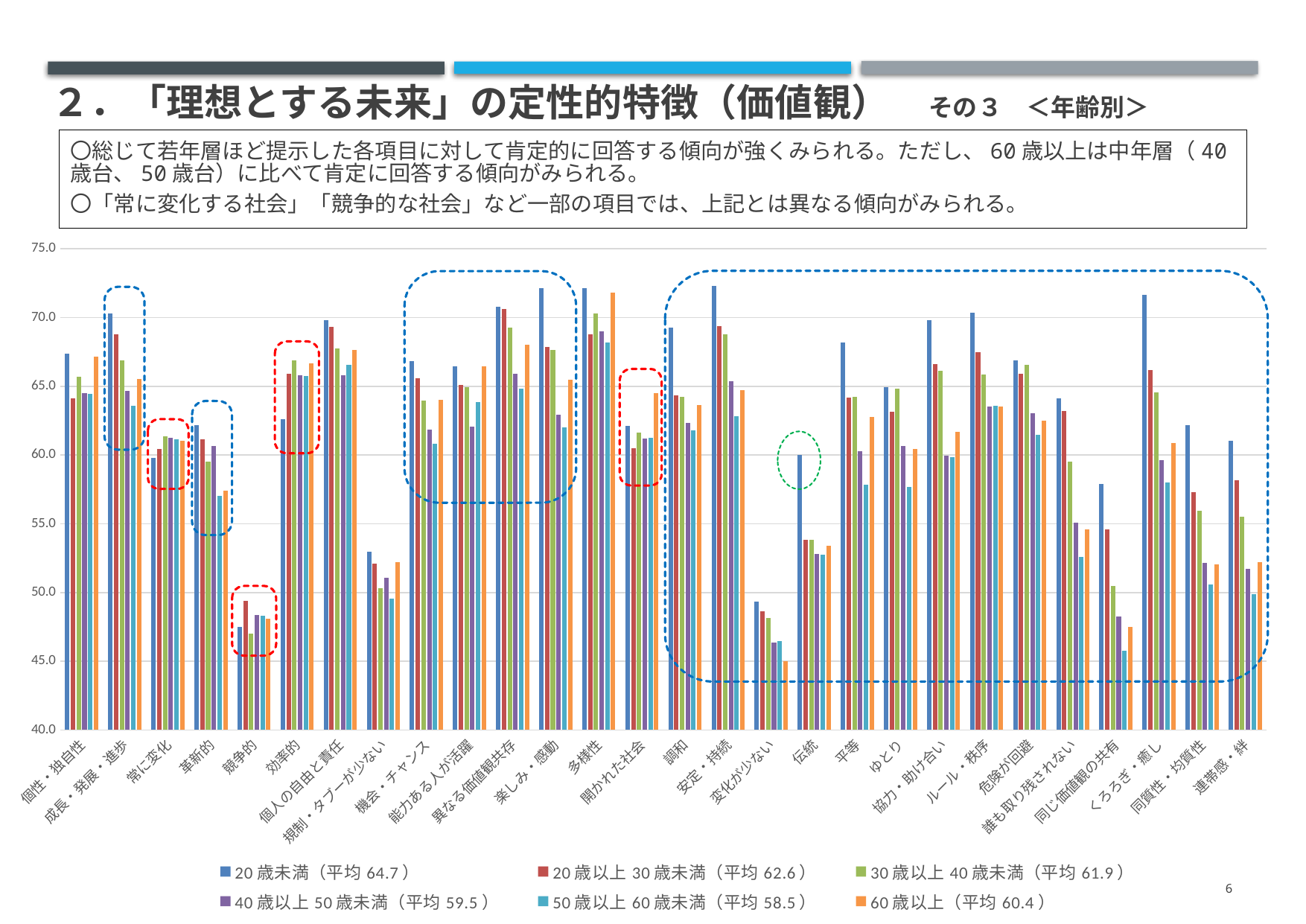
How many series does the legend list? 6 According to the legend, which series has the lowest average (平均)? 50歳以上60歳未満（平均 58.5） What kind of chart is shown on the slide? bar chart Is the value for 20歳未満 in the 安定・持続 category greater or less than 70? greater Is the value for 20歳未満 in the 変化が少ない category greater or less than 50? less Is the value for 60歳以上 in the 伝統 category greater or less than 50? greater In the 伝統 category, which is larger: the value for 20歳未満 or the value for 60歳以上? 20歳未満 In the 安定・持続 category, which age group has the highest value? 20歳未満 How many categories are shown along the x axis? 28 According to the legend, what is the average (平均) for the 20歳未満 series? 64.7